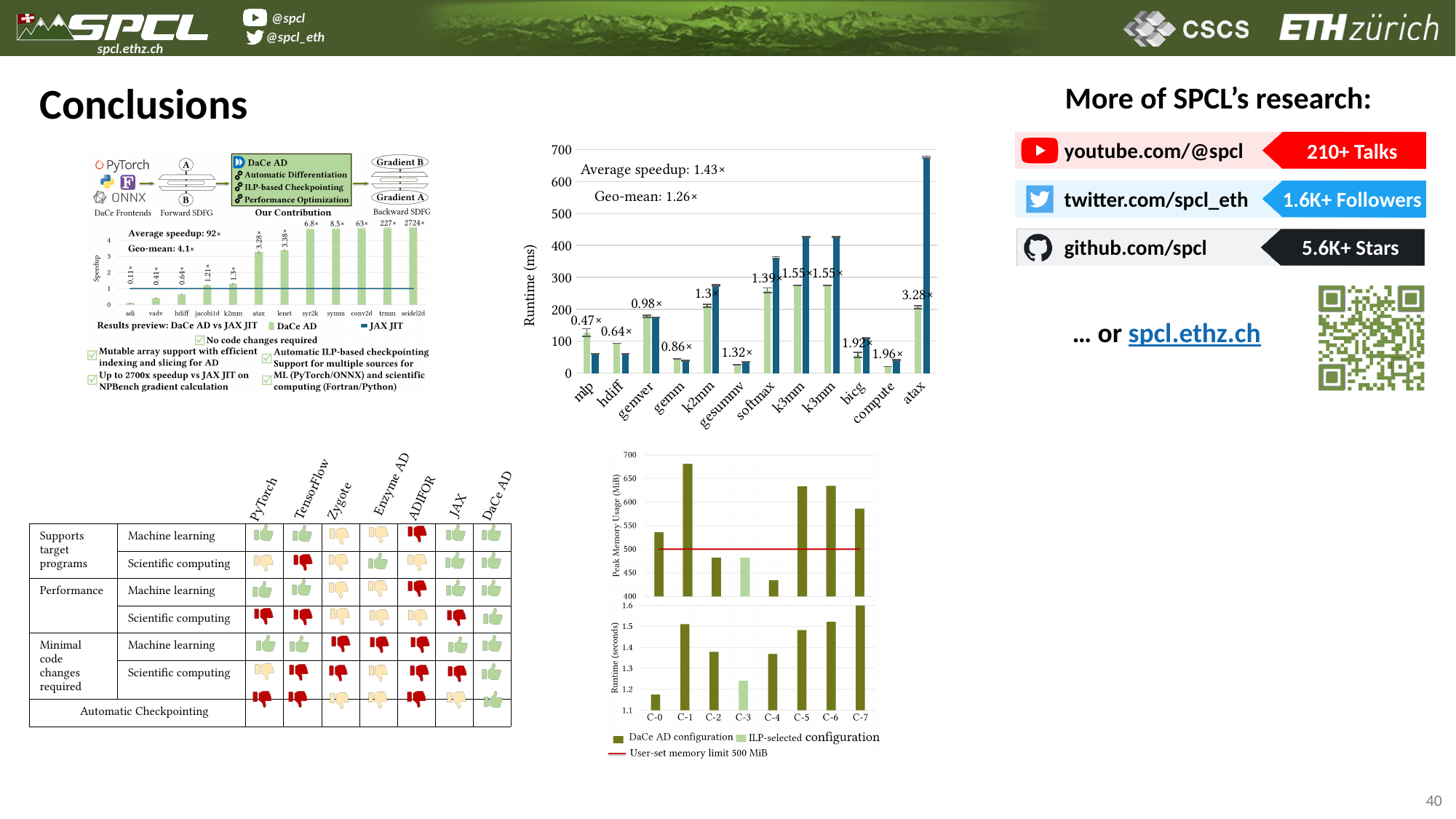
In the 'Results preview: DaCe AD vs JAX JIT' chart at the top left, how many benchmarks are shown on the x axis? 12 In the 'Results preview: DaCe AD vs JAX JIT' chart at the top left, which benchmark has the lowest labelled speedup? adi In the Peak Memory Usage (MiB) chart at the bottom middle, what user-set memory limit does the red line represent? 500 MiB In the Peak Memory Usage (MiB) chart at the bottom middle, is the value for C-1 greater or less than 650? greater In the Runtime (ms) chart in the top middle, which benchmark has the lowest labelled speedup? mlp In the Runtime (seconds) chart at the bottom middle, is the value for C-0 greater or less than 1.2? less In the Runtime (ms) chart in the top middle, is the taller (blue) bar for atax greater or less than 600 ms? greater In the 'Results preview: DaCe AD vs JAX JIT' chart at the top left, which two series does the legend list? DaCe AD and JAX JIT In the Runtime (ms) chart in the top middle, what speedup is labelled for atax? 3.28× In the 'Results preview: DaCe AD vs JAX JIT' chart at the top left, what speedup is labelled for seidel2d? 2724× In the 'Results preview: DaCe AD vs JAX JIT' chart at the top left, what average speedup is stated? 92× In the Runtime (ms) chart in the top middle, what geo-mean speedup is stated? 1.26×